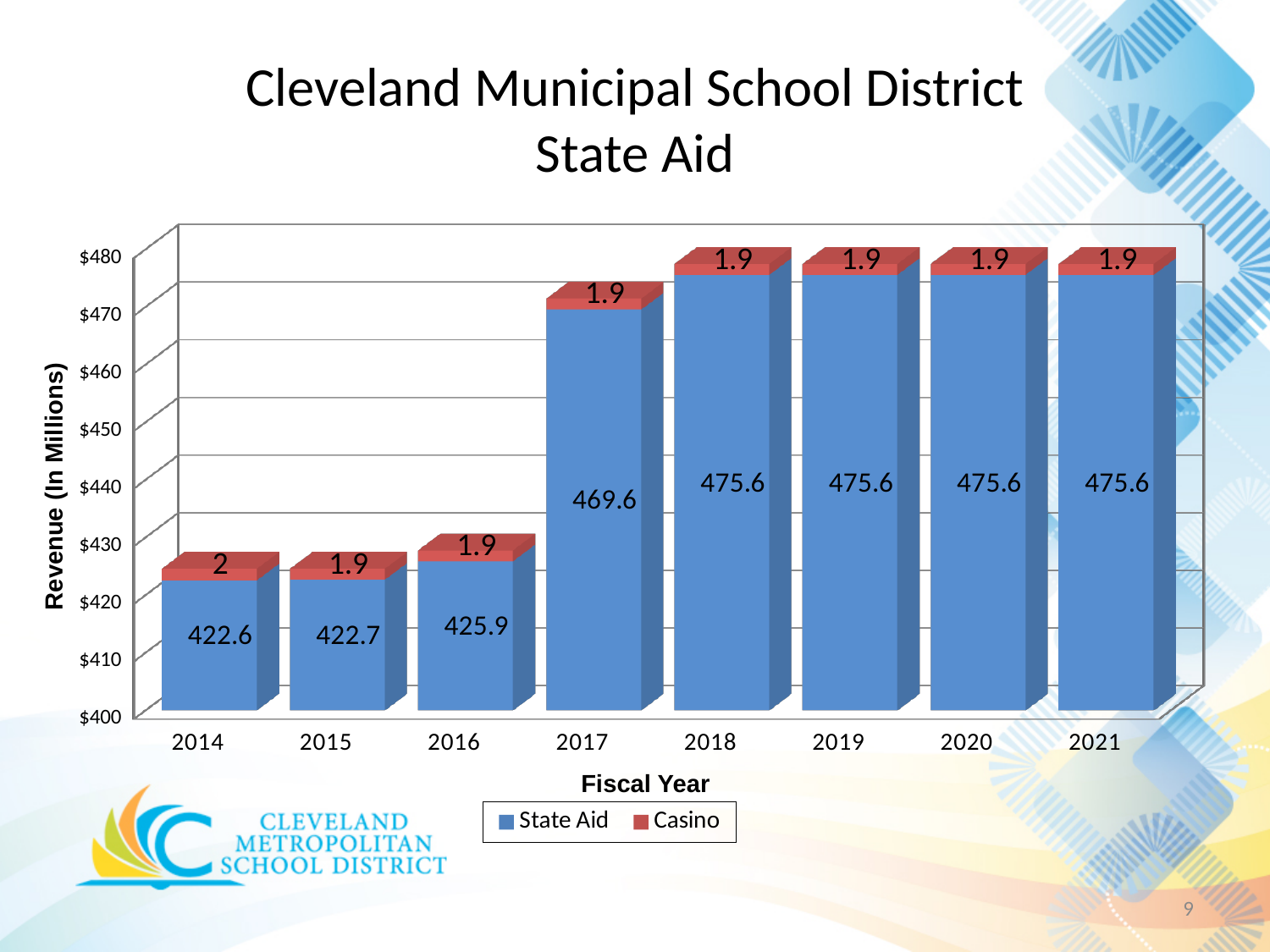
Is the State Aid value larger in 2015 or in 2017? 2017 What is the Casino value for fiscal year 2014? 2 Which fiscal year has the lowest State Aid value? 2014 What kind of chart is shown on the slide? Stacked bar chart What is the State Aid value for fiscal year 2016? 425.9 Does the State Aid value rise or fall from 2014 to 2018? Rise What is the total of the stacked bar for fiscal year 2018? 477.5 How many fiscal years are shown on the x axis? 8 What is the State Aid value for fiscal year 2017? 469.6 How many series does the legend list? 2 What is the difference in State Aid between 2017 and 2016? 43.7 What is the label of the y axis? Revenue (In Millions)